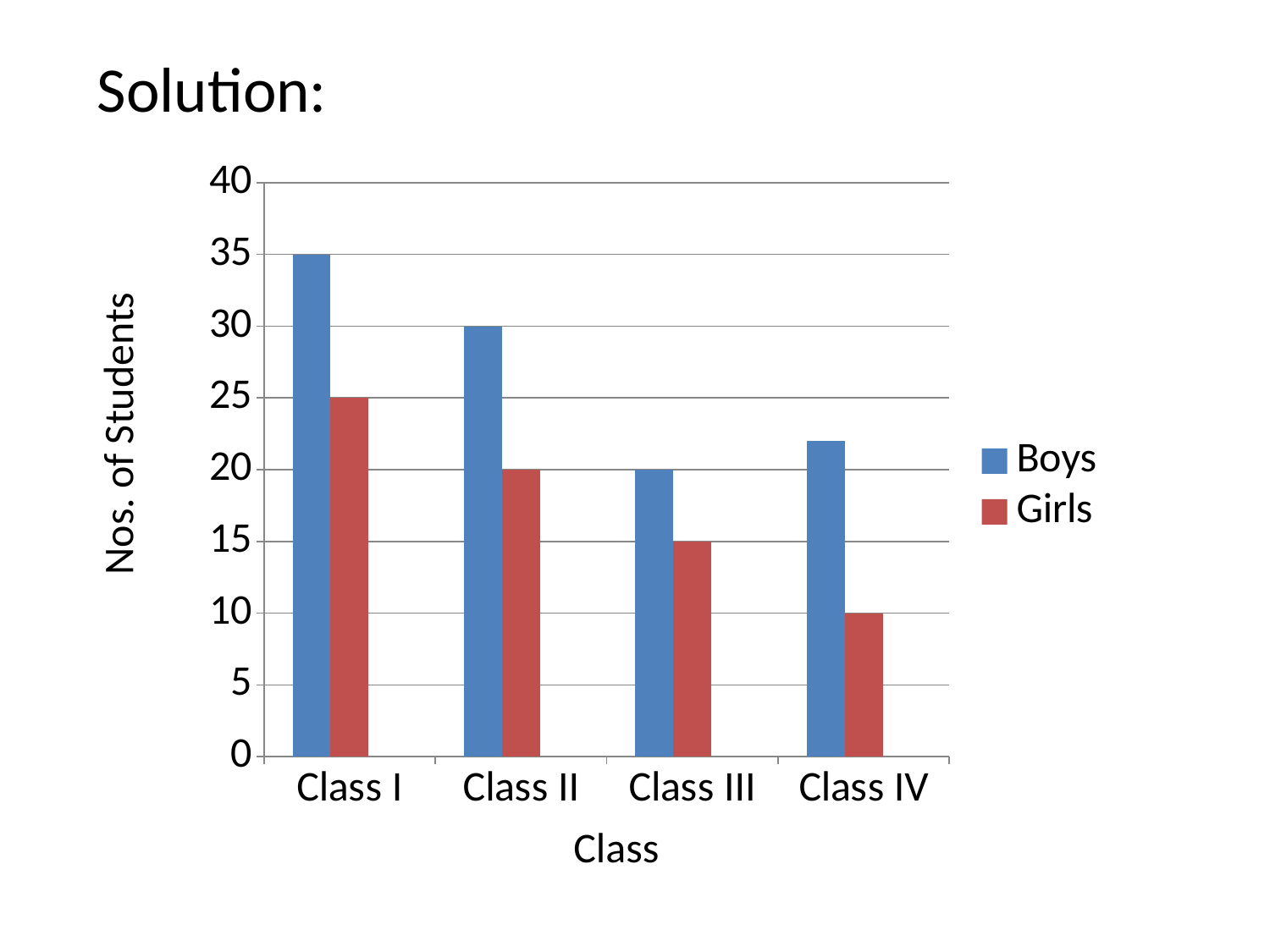
Which class has the highest number of Boys? Class I What is the number of Girls in Class IV? 10 Is the number of Boys in Class IV greater or less than 20? greater Which is larger, the number of Boys in Class II or the number of Girls in Class I? Boys in Class II What is the number of Girls in Class II? 20 Do the Girls values rise or fall from Class I to Class IV? fall How many series does the legend list? 2 What is the number of Boys in Class I? 35 How many classes are shown on the x axis? 4 What type of chart is shown on the slide? bar chart What is the difference between the number of Boys and Girls in Class I? 10 Which class has the lowest number of Girls? Class IV